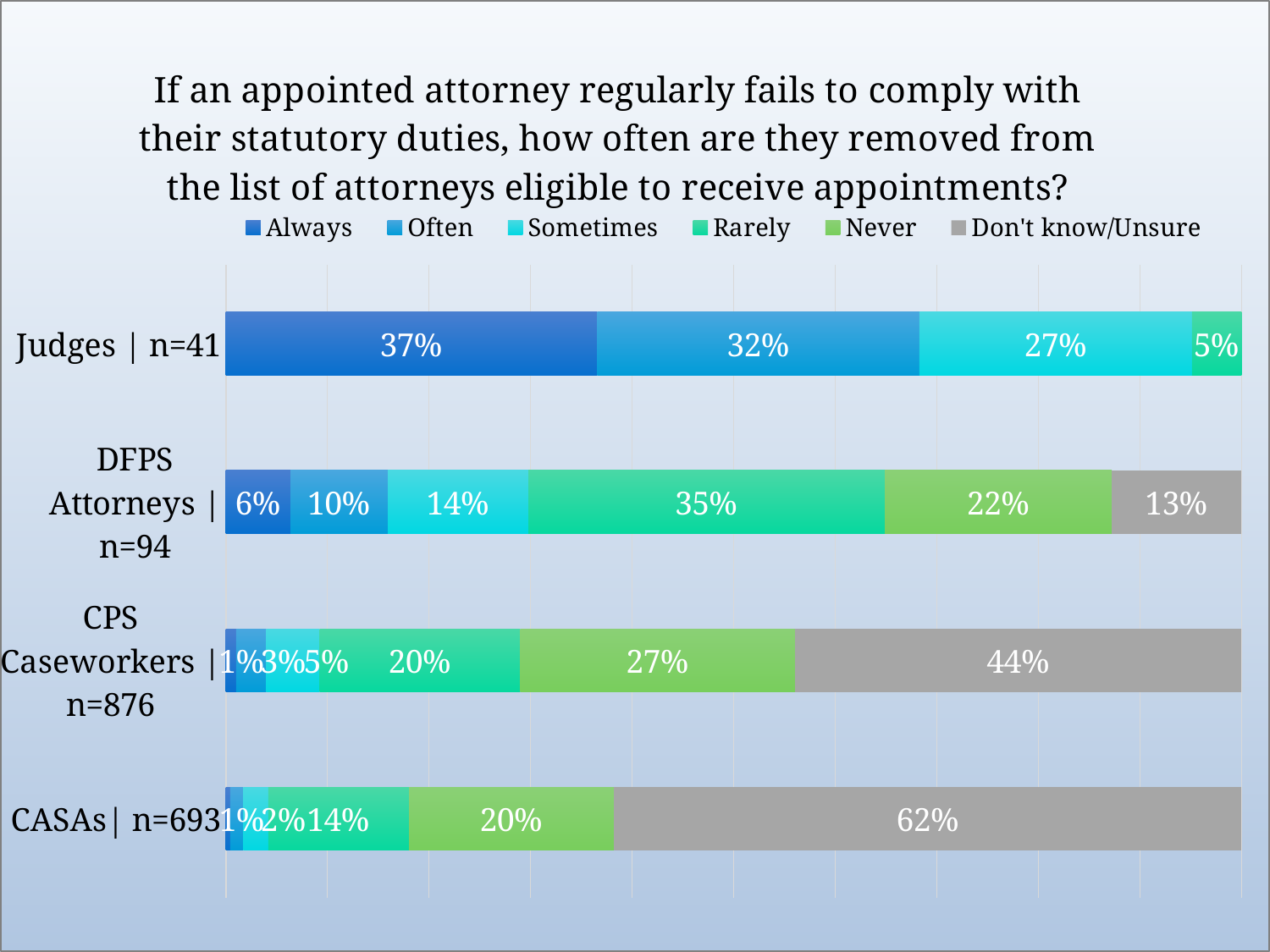
Which respondent group has the highest share of "Don't know/Unsure" responses? CASAs | n=693 What percentage of DFPS Attorneys answered "Rarely"? 35% What percentage of CPS Caseworkers answered "Don't know/Unsure"? 44% Which group has a larger "Often" share, Judges or DFPS Attorneys? Judges How many percentage points higher is the "Don't know/Unsure" share for CASAs than for CPS Caseworkers? 18 percentage points What percentage of Judges answered "Always"? 37% What percentage of DFPS Attorneys answered "Never"? 22% What percentage of CASAs answered "Don't know/Unsure"? 62% How many respondent groups are shown on the chart? 4 What type of chart is shown on the slide? Stacked bar chart How many response categories does the legend list? 6 Which respondent group has the highest share of "Always" responses? Judges | n=41